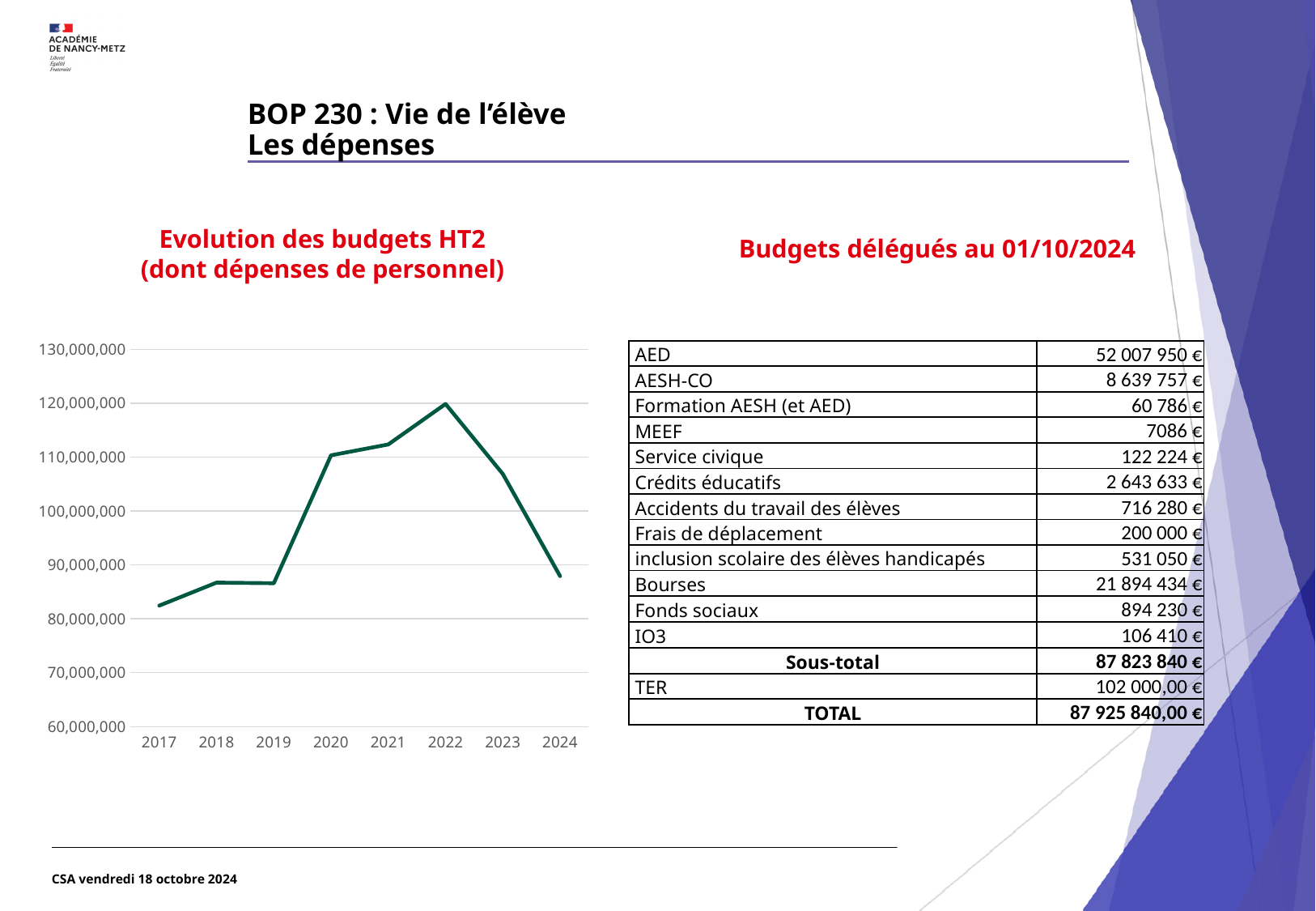
In which year does the chart reach its highest value? 2022 Is the value for 2017 greater or less than 80,000,000? greater Does the line rise or fall between 2022 and 2024? fall What kind of chart is shown on the slide? line chart How many years are plotted on the x axis of the chart? 8 Is the value for 2022 greater or less than 110,000,000? greater Which year has the larger value, 2019 or 2020? 2020 In which year does the chart show its lowest value? 2017 Is the value for 2024 greater or less than 90,000,000? less Which year has the larger value, 2023 or 2024? 2023 What is the title of the chart? Evolution des budgets HT2 (dont dépenses de personnel)